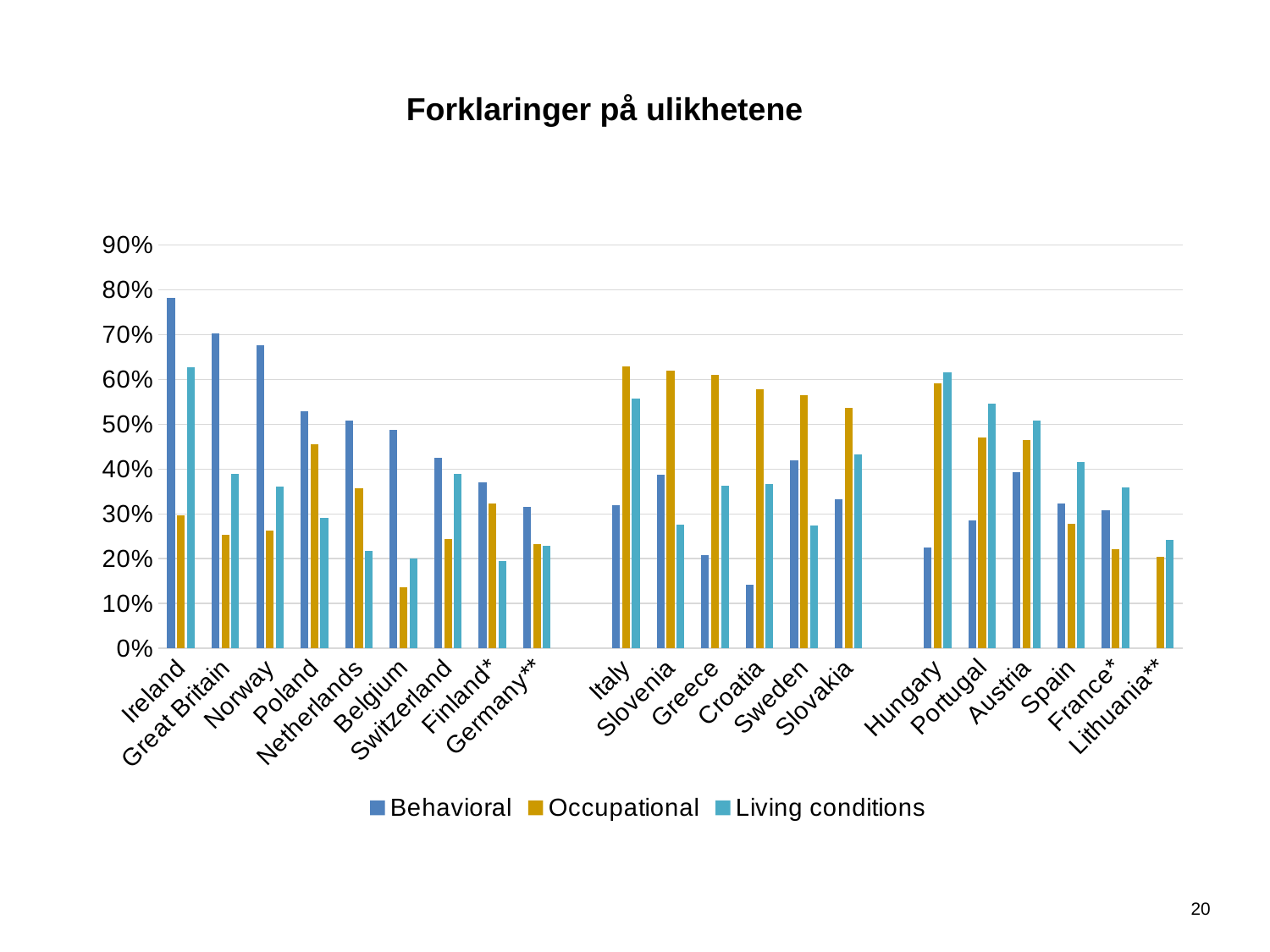
What is the title of the chart? Forklaringer på ulikhetene How many series does the legend list? 3 For Sweden, which is larger: the Occupational value or the Living conditions value? Occupational Which series are listed in the legend? Behavioral, Occupational, Living conditions Is the Behavioral value for Croatia greater or less than 20%? less Which country has the highest Behavioral value? Ireland Is the Occupational value for Belgium greater or less than 20%? less Which country has the lowest Occupational value? Belgium Is the Behavioral value for Ireland greater or less than 70%? greater For Italy, which is larger: the Occupational value or the Behavioral value? Occupational What kind of chart is shown on the slide? Bar chart How many countries are shown on the x axis? 21